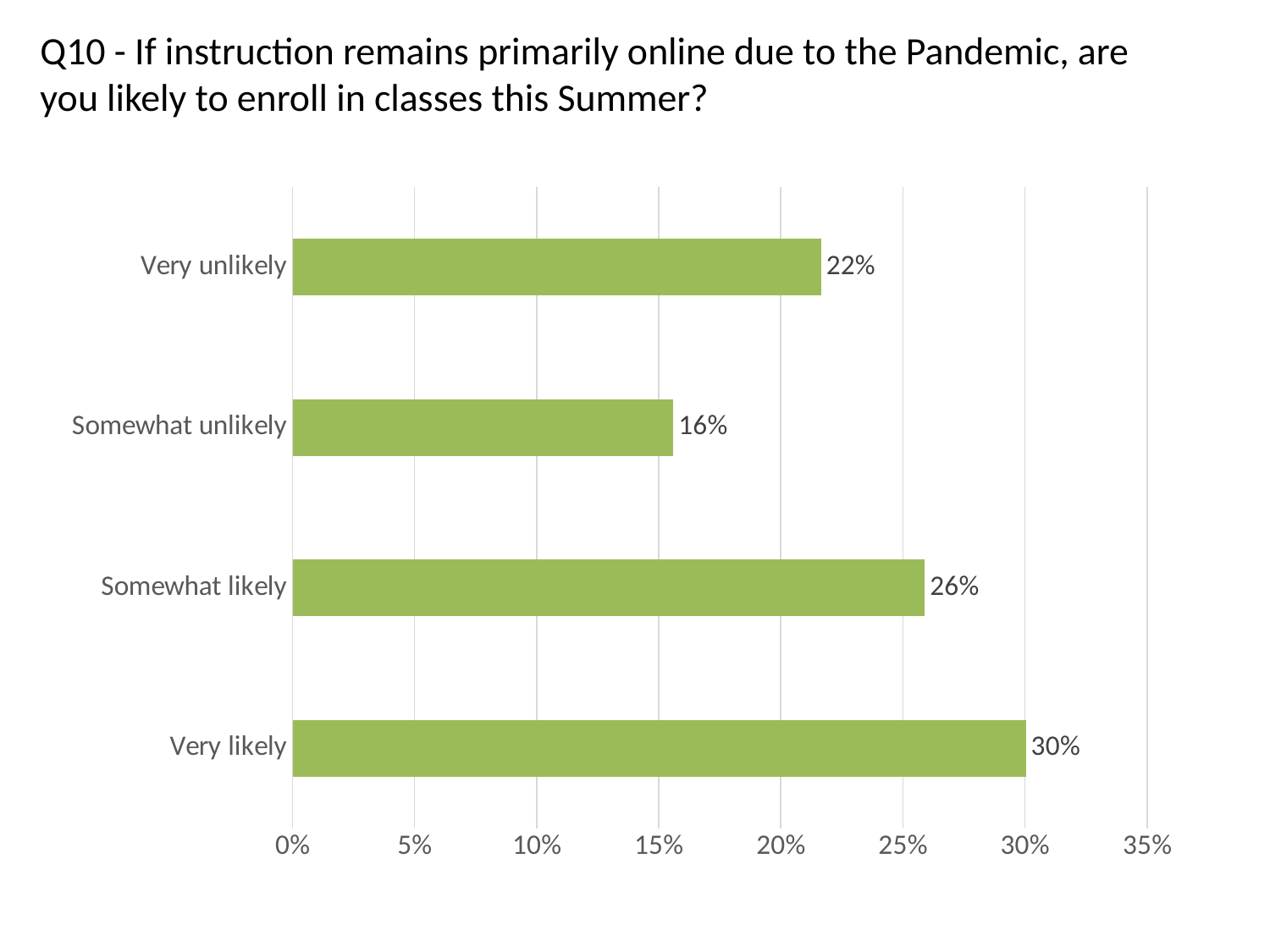
What type of chart is shown on the slide? Bar chart Which response category has the highest percentage? Very likely Is the value for "Somewhat likely" greater or less than 25%? greater What percentage of respondents answered "Very unlikely"? 22% What is the difference in percentage points between "Very likely" and "Very unlikely"? 8% How many response categories are shown in the chart? 4 Which is larger, the percentage for "Somewhat likely" or for "Very unlikely"? Somewhat likely What percentage of respondents answered "Somewhat unlikely"? 16% What is the maximum value shown on the horizontal axis? 35% What percentage of respondents answered "Very likely"? 30% Which response category has the lowest percentage? Somewhat unlikely What is the difference in percentage points between "Somewhat likely" and "Somewhat unlikely"? 10%